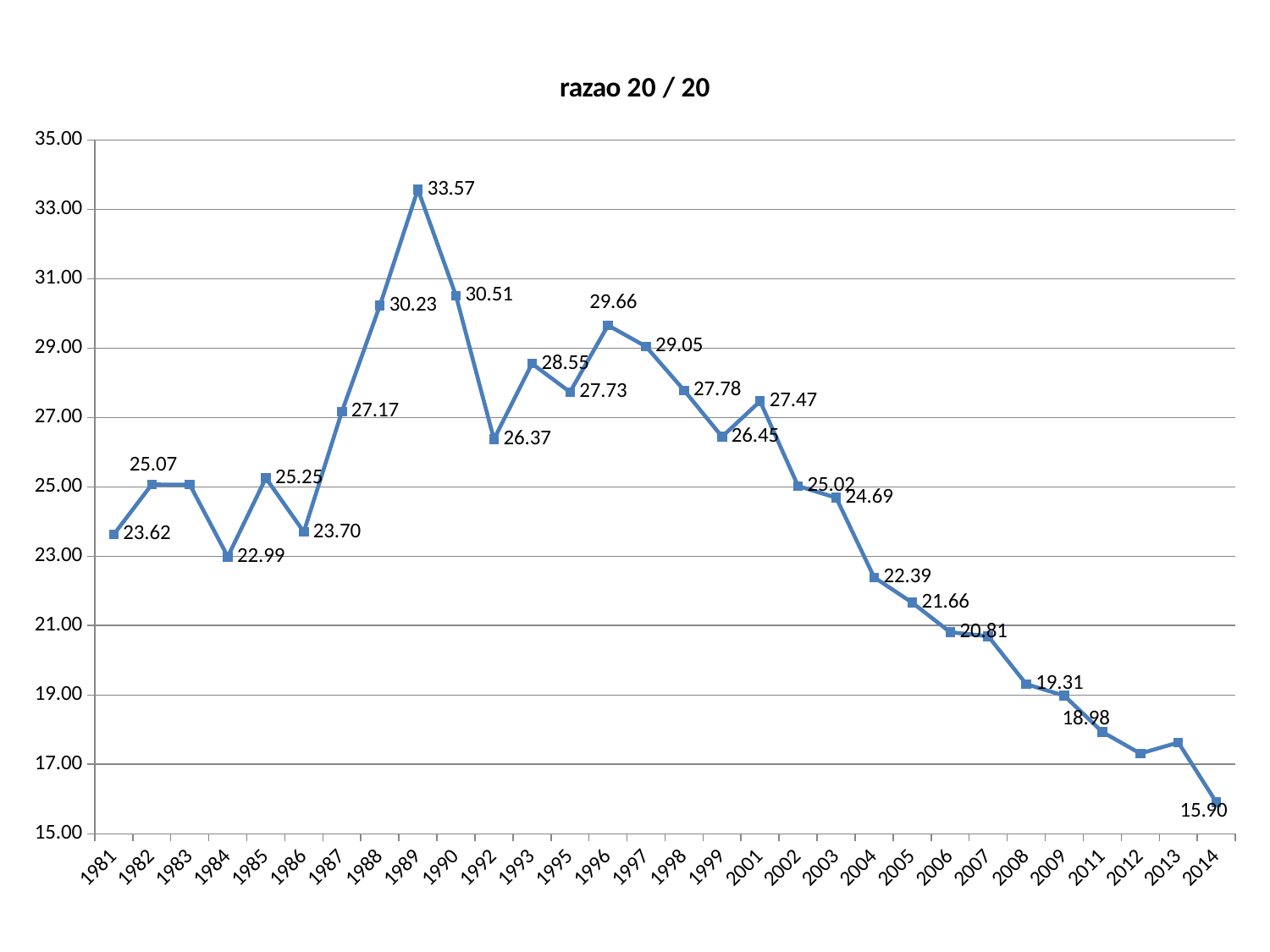
How many years are plotted on the x axis? 30 What is the value for 1989? 33.57 Which year has the highest value? 1989 Is the value for 2011 greater or less than 19.00? less What is the value for 2014? 15.90 Which year has the lowest value? 2014 What is the difference between the values for 1989 and 2014? 17.67 What kind of chart is this? line chart Which is larger, the value for 1988 or the value for 1990? 1990 Do the values rise or fall from 2001 to 2014? fall What is the title of the chart? razao 20 / 20 What is the difference between the values for 1998 and 1999? 1.33